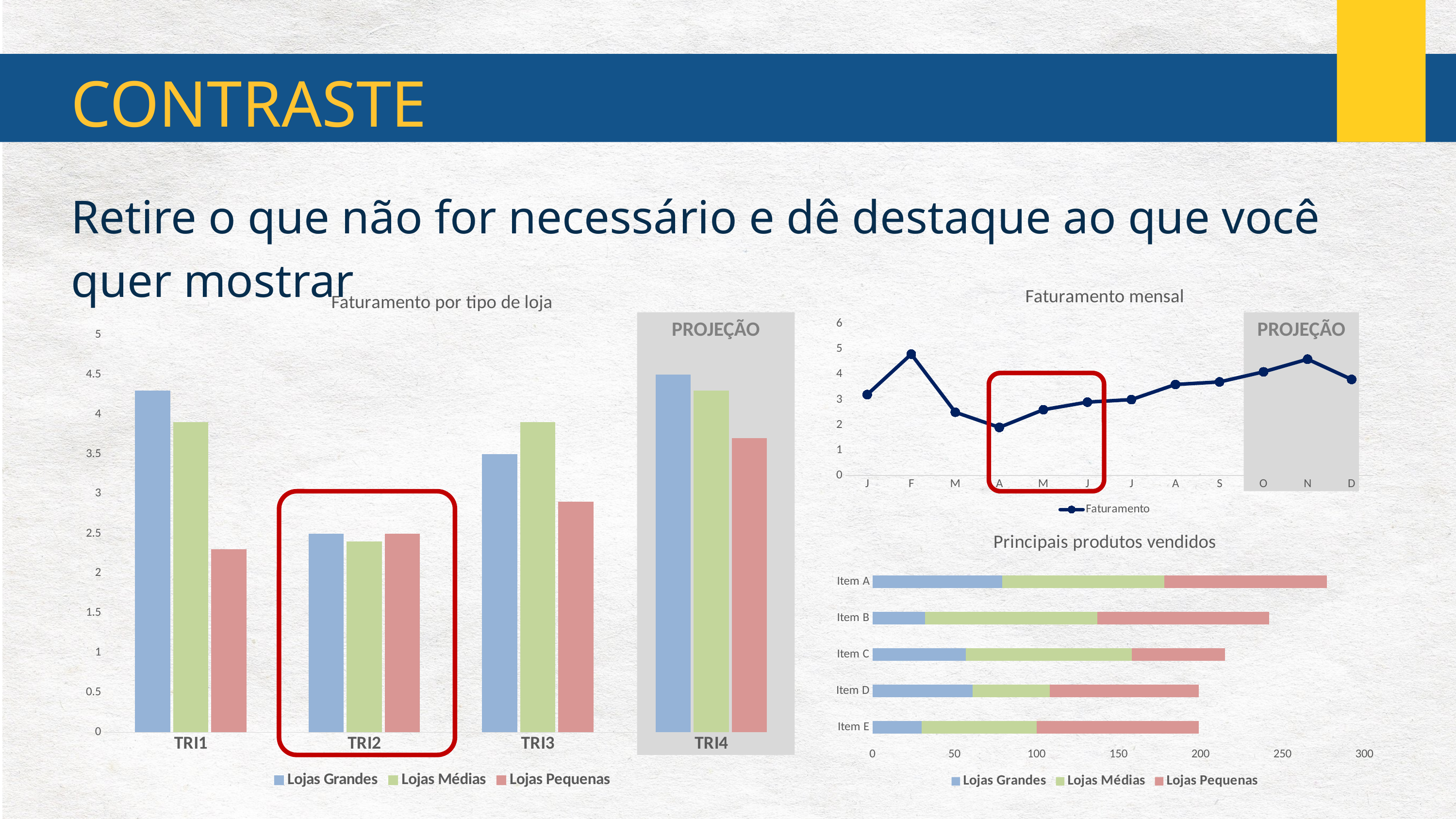
What kind of chart is "Faturamento mensal"? line chart In "Faturamento mensal", is the value for F greater or less than 4? greater In "Principais produtos vendidos", which item has the longest total bar? Item A What kind of chart is "Faturamento por tipo de loja"? bar chart In "Principais produtos vendidos", how many items are listed on the vertical axis? 5 In "Faturamento por tipo de loja", which is larger in TRI3: Lojas Grandes or Lojas Médias? Lojas Médias In "Faturamento por tipo de loja", how many series does the legend list? 3 In "Faturamento por tipo de loja", how many quarters are shown on the x axis? 4 In "Faturamento por tipo de loja", which series has the highest value in TRI1? Lojas Grandes In "Faturamento mensal", which month has the lowest value? A In "Faturamento por tipo de loja", is the value for Lojas Pequenas in TRI1 greater or less than 3? less In "Faturamento mensal", which month has the highest value? F